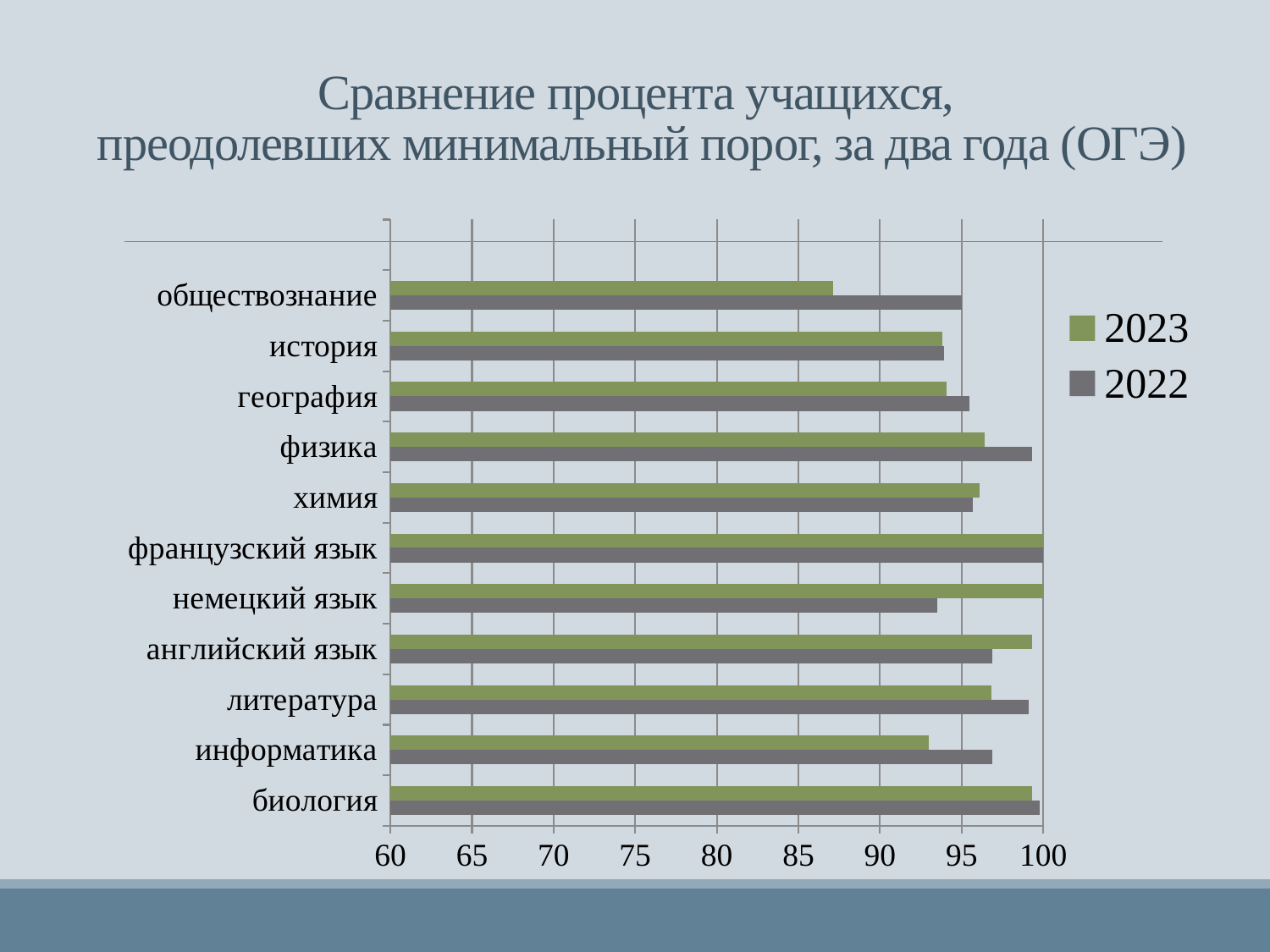
For обществознание, which year has the larger value, 2022 or 2023? 2022 Is the 2023 value for обществознание greater or less than 90? less For физика, which year has the larger value, 2022 or 2023? 2022 Which colour represents 2023 in the chart? green For немецкий язык, which year has the larger value, 2022 or 2023? 2023 How many series does the legend list? 2 Which years are listed in the legend? 2023 and 2022 Is the 2023 value for информатика greater or less than 95? less What kind of chart is shown on the slide? bar chart How many subjects (categories) are shown on the chart? 11 Which subject has the lowest 2023 value? обществознание Is the 2022 value for обществознание greater or less than 90? greater